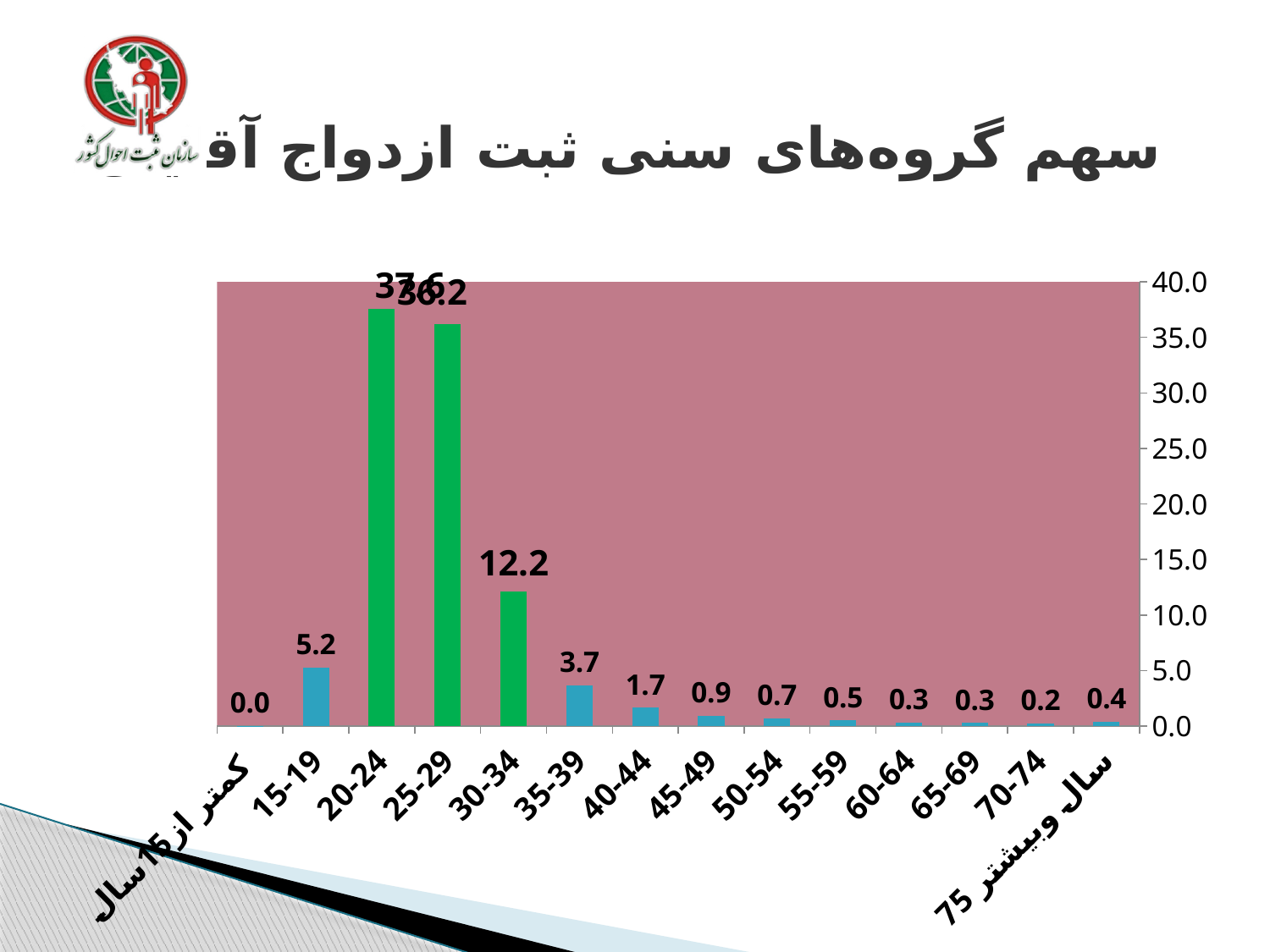
What is the value for the 30-34 age group? 12.2 What is the value for the 40-44 age group? 1.7 Do the values rise or fall along the x axis from the 20-24 group to the 70-74 group? fall What kind of chart is shown on the slide? bar chart What is the value for the 25-29 age group? 36.2 Is the value for the 30-34 age group greater or less than 10.0? greater Which age group has the highest value? 20-24 Which age group has the lowest value? کمتر از 15 سال What is the value for the 15-19 age group? 5.2 Which is larger, the value for 15-19 or the value for 35-39? 15-19 How many age groups are shown on the x axis? 14 What is the difference between the values for 30-34 and 15-19? 7.0